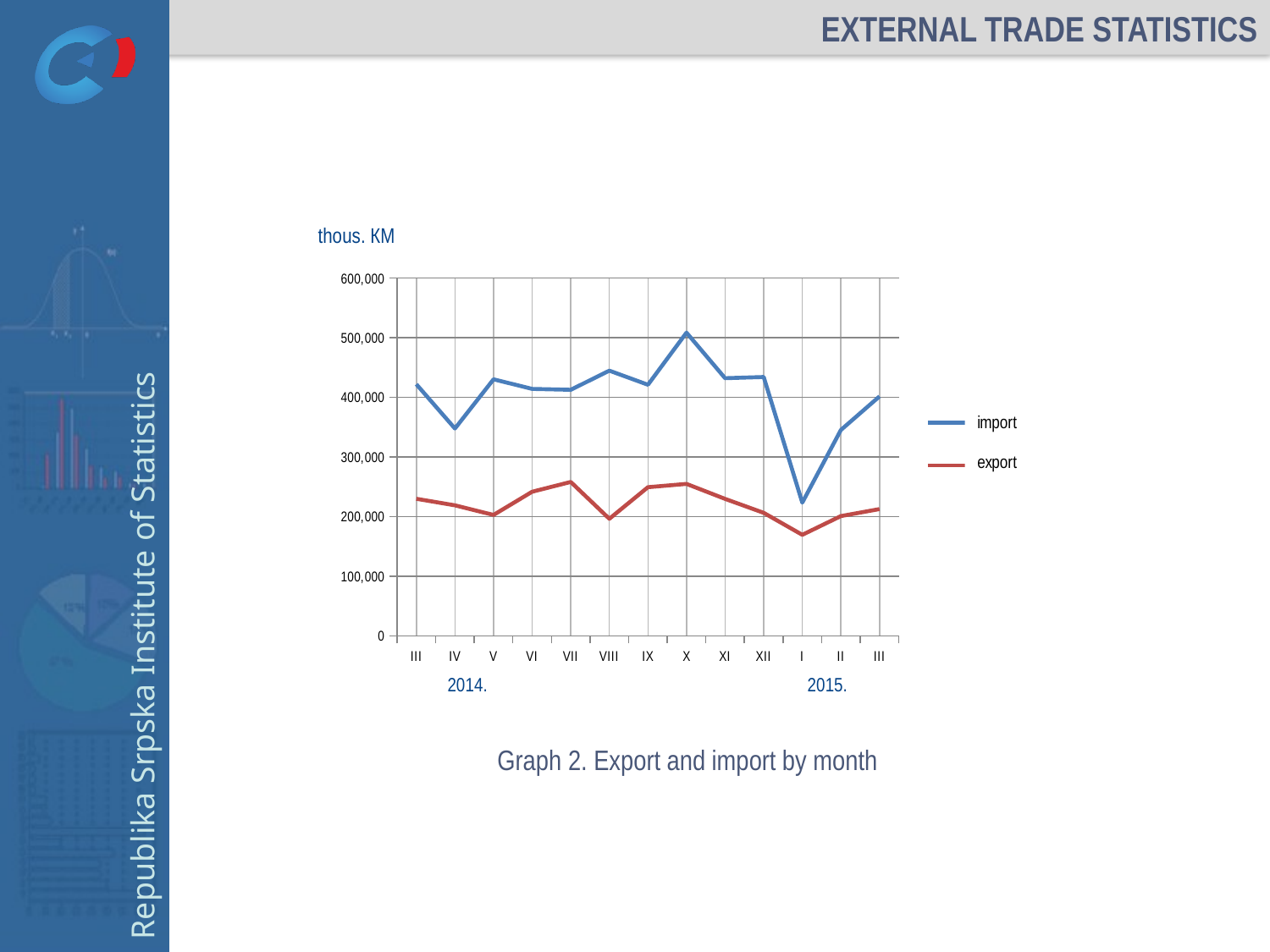
In which month does the import line reach its lowest value? I 2015 Is the import value for X 2014 greater or less than 500,000? greater In which month does the export line reach its lowest value? I 2015 Is the import value for I 2015 greater or less than 300,000? less Is the export value for I 2015 greater or less than 200,000? less Does the import line rise or fall from X 2014 to I 2015? fall What unit is stated above the chart? thous. KM Which is larger in VII 2014, import or export? import How many monthly points are plotted along the x axis? 13 How many series does the legend list? 2 In which month does the import line reach its highest value? X 2014 What kind of chart is shown on the slide? line chart